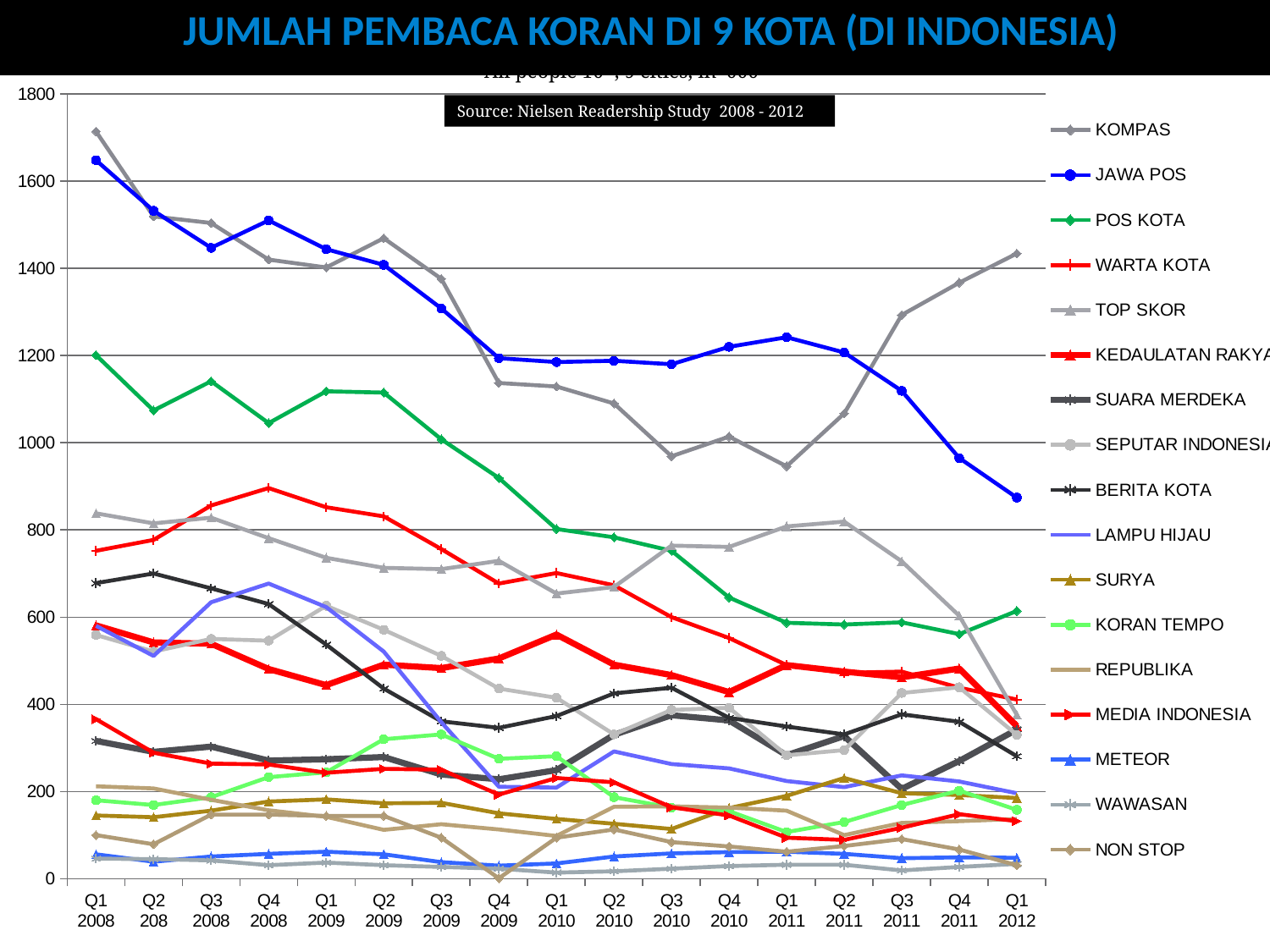
How many quarters are plotted along the x axis? 17 Does the JAWA POS line rise or fall overall from Q1 2008 to Q1 2012? fall Which newspaper has the highest readership in Q1 2012? KOMPAS Is the value for KOMPAS in Q1 2008 greater or less than 1600? greater Which newspaper has the lowest readership in Q4 2009? NON STOP What kind of chart is shown on the slide? line chart Is the value for WARTA KOTA in Q4 2008 greater or less than 800? greater How many series does the legend list? 17 Is the value for JAWA POS in Q1 2012 greater or less than 1000? less Which is larger in Q4 2010, KOMPAS or JAWA POS? JAWA POS Which newspaper has the highest readership in Q1 2008? KOMPAS